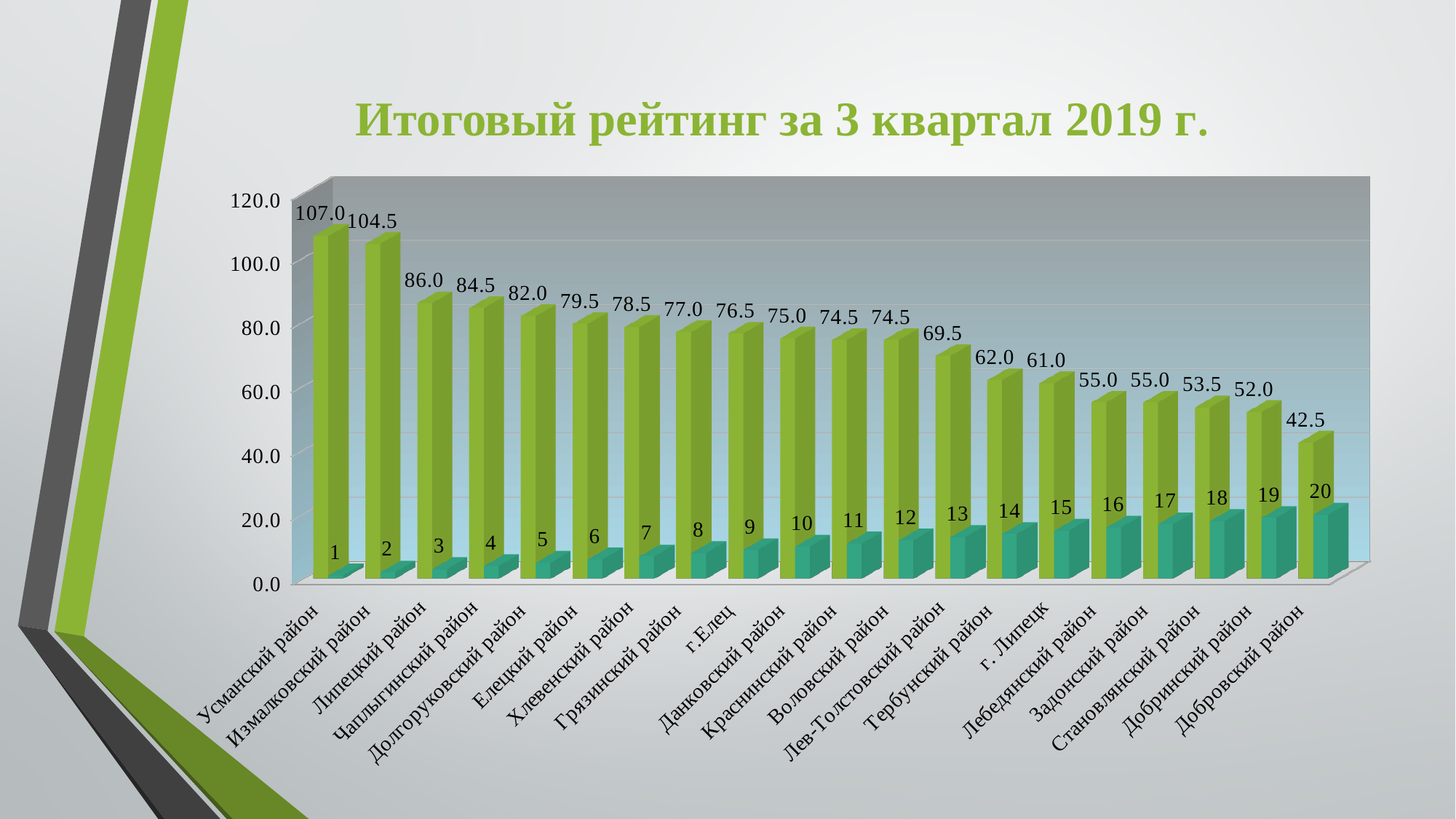
What is the value of the tall green bar for г. Липецк? 61.0 Which category has the highest green bar value? Усманский район Which category has the lowest green bar value? Добровский район What rank number is shown for Лев-Толстовский район? 13 What kind of chart is shown on the slide? bar chart What is the value of the tall green bar for Усманский район? 107.0 What is the difference between the green bar values for Липецкий район and Добровский район? 43.5 What is the title of the chart? Итоговый рейтинг за 3 квартал 2019 г. How many categories are shown on the x axis? 20 Which has a larger green bar value, Тербунский район or Задонский район? Тербунский район Is the green bar value for Добровский район greater or less than 60.0? less What is the difference between the green bar values for Усманский район and Измалковский район? 2.5